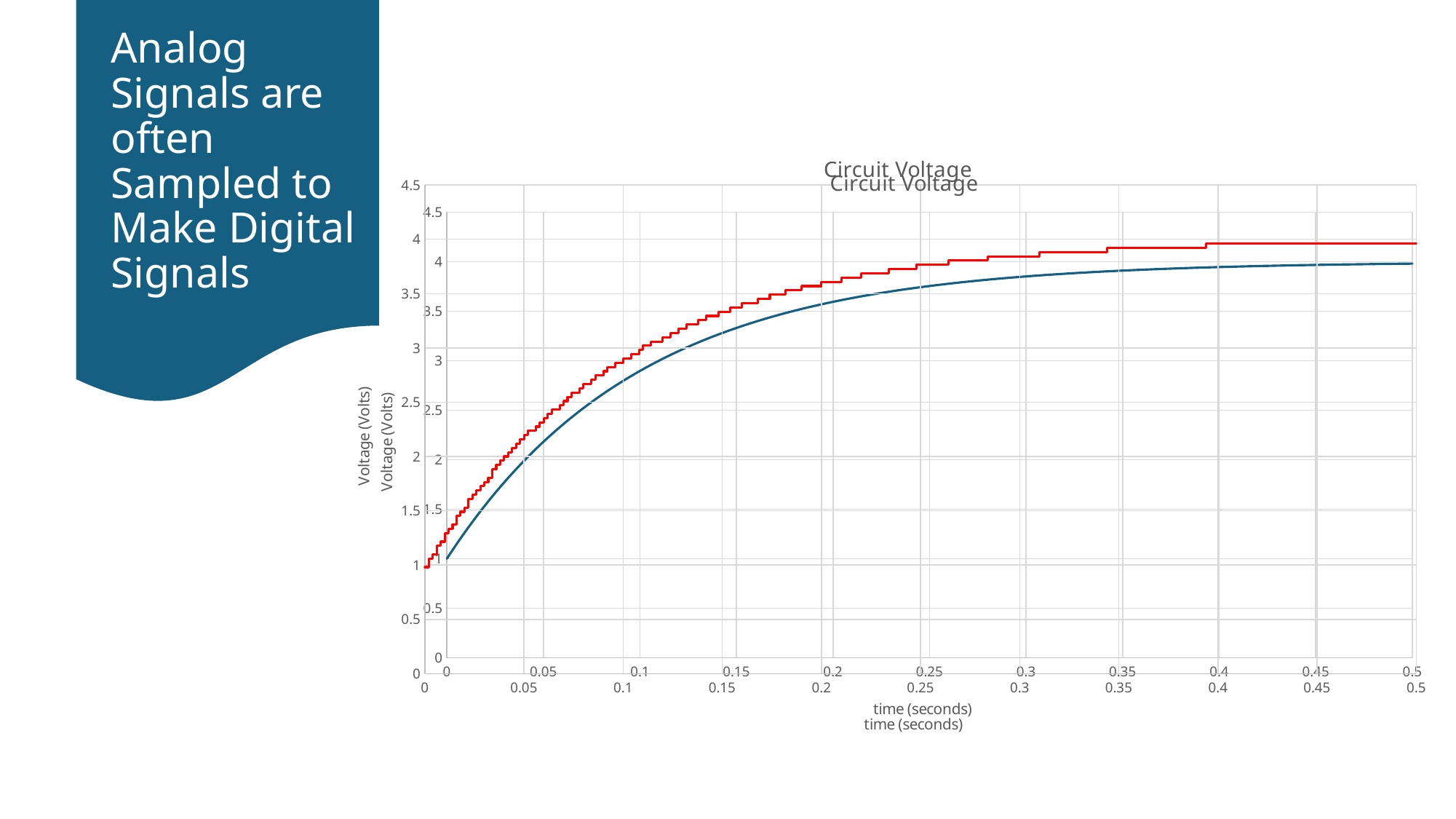
Is the value of the blue curve at 0.5 seconds greater or less than 3.5? greater What is the label of the x axis of the chart? time (seconds) Is the value of the blue curve at 0.1 seconds greater or less than 2.5? greater What is the title of the chart? Circuit Voltage Is the value of the blue curve at 0.05 seconds greater or less than 1.5? greater What kind of chart is shown on the slide? line chart Do the values of the blue curve rise or fall as time increases? rise Do the values of the red stepped line rise or fall as time increases? rise